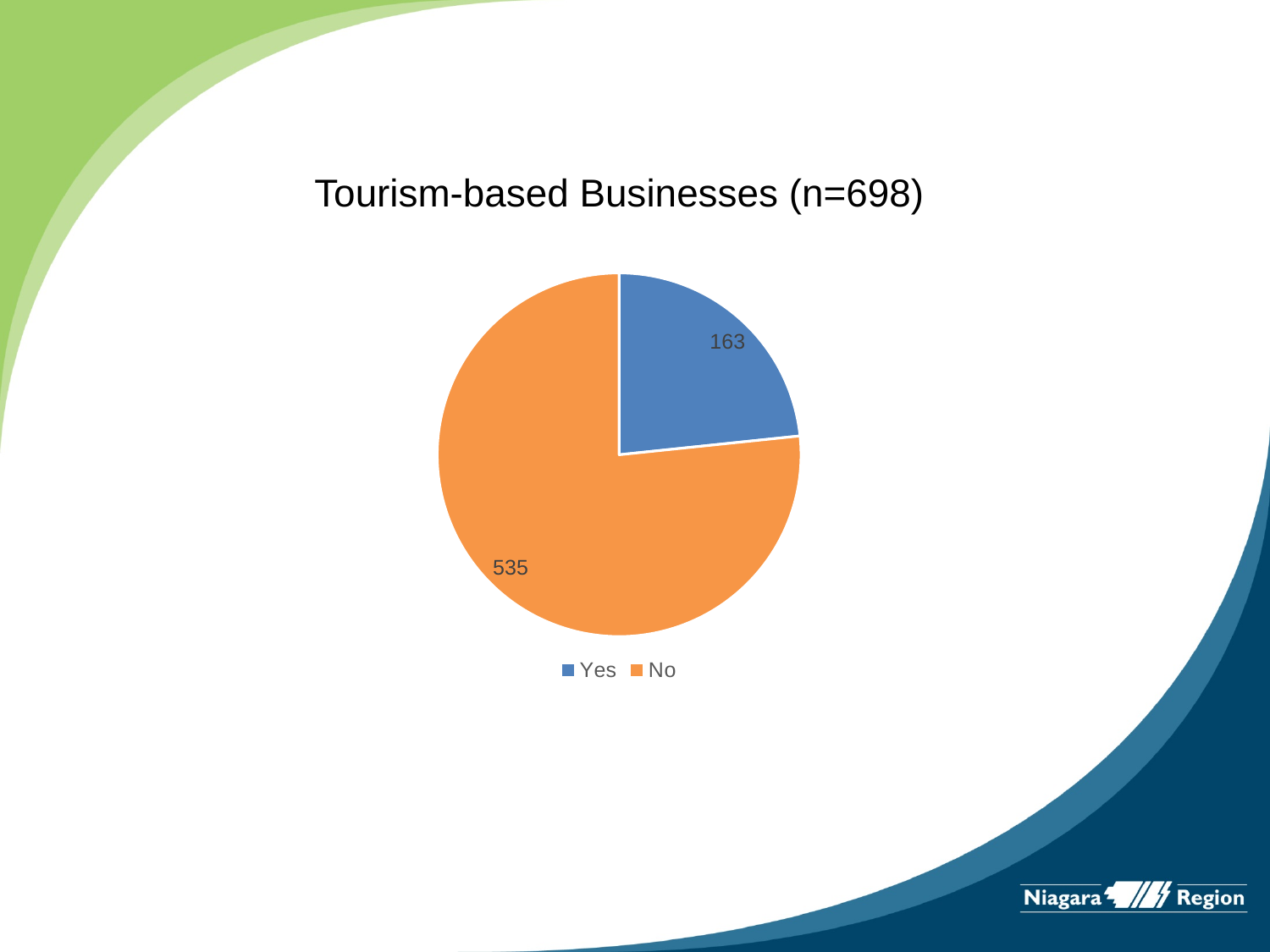
Which is larger, the Yes value or the No value? No What type of chart is shown on the slide? pie chart What is the difference between the No and Yes values? 372 What colour is the No slice? orange What is the total of the two slices? 698 Which category has the largest slice? No How many entries does the legend list? 2 How many slices does the pie chart have? 2 What is the value for the Yes slice? 163 What is the title of the chart? Tourism-based Businesses (n=698) Which category has the smallest slice? Yes What is the value for the No slice? 535